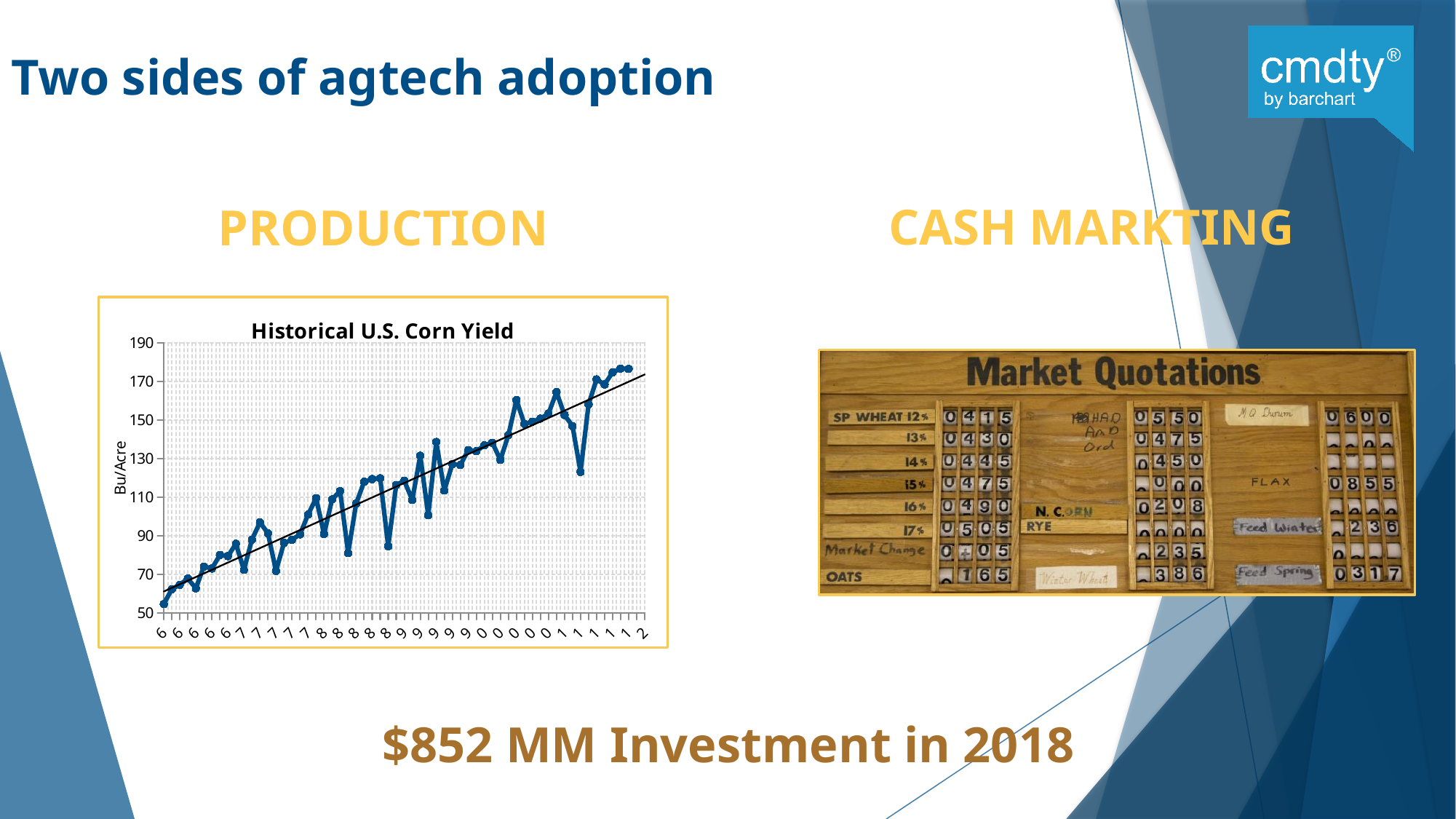
What is the highest value shown on the vertical axis of the Historical U.S. Corn Yield chart? 190 In the Historical U.S. Corn Yield chart, is the last (rightmost) value greater or less than 170? greater In the Historical U.S. Corn Yield chart, which is larger: the first value on the left or the last value on the right? the last value on the right What is the lowest value shown on the vertical axis of the Historical U.S. Corn Yield chart? 50 What is the title of the chart on the slide? Historical U.S. Corn Yield In the Historical U.S. Corn Yield chart, is the highest plotted value greater or less than 150? greater What kind of chart is the Historical U.S. Corn Yield chart? line chart In the Historical U.S. Corn Yield chart, is the lowest plotted value greater or less than 90? less Do the values in the Historical U.S. Corn Yield chart generally rise or fall from left to right? rise What is the label on the vertical axis of the Historical U.S. Corn Yield chart? Bu/Acre